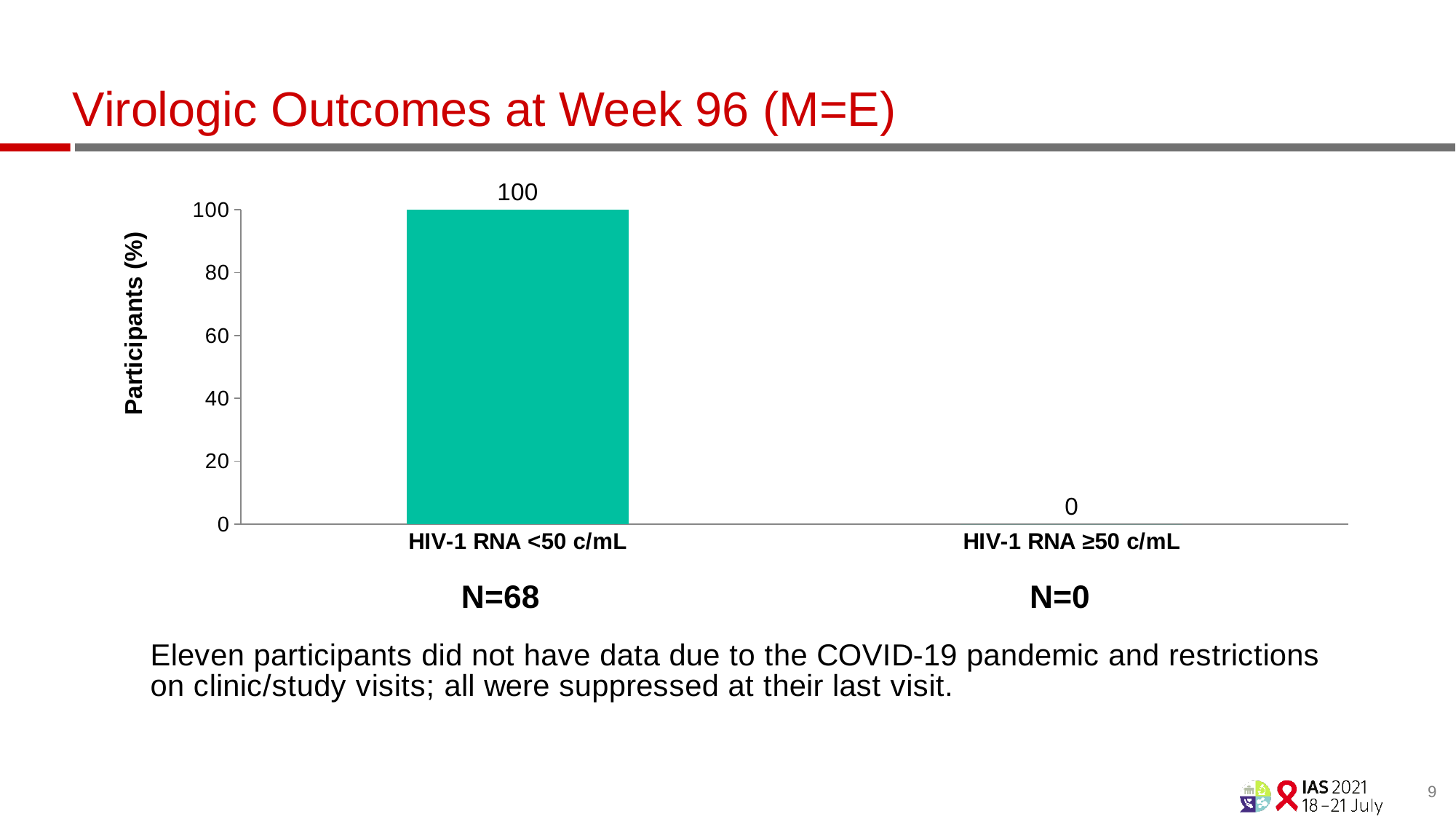
How many categories are shown on the x axis? 2 Is the value for HIV-1 RNA <50 c/mL greater or less than 80? greater Which category has the highest value? HIV-1 RNA <50 c/mL What is the N shown under the HIV-1 RNA <50 c/mL bar? N=68 Which is larger, the value for HIV-1 RNA <50 c/mL or HIV-1 RNA ≥50 c/mL? HIV-1 RNA <50 c/mL Which category has the lowest value? HIV-1 RNA ≥50 c/mL What kind of chart is shown on the slide? bar chart What is the value for HIV-1 RNA ≥50 c/mL? 0 What is the label of the y axis? Participants (%) What is the difference between the values for HIV-1 RNA <50 c/mL and HIV-1 RNA ≥50 c/mL? 100 What is the value for HIV-1 RNA <50 c/mL? 100